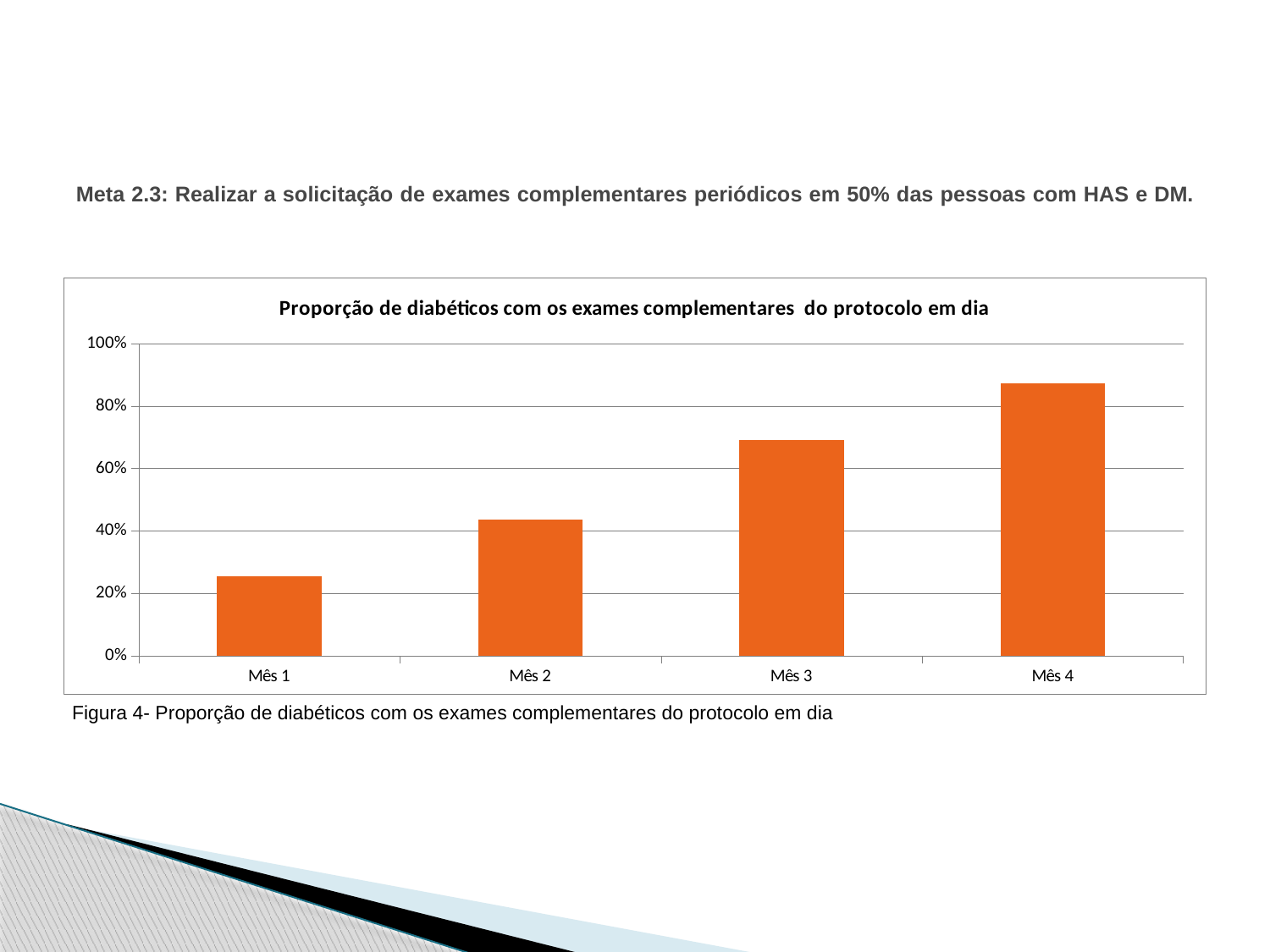
Is the value for Mês 1 greater or less than 40%? less Is the value for Mês 2 greater or less than 40%? greater How many months (categories) are plotted on the x axis? 4 Is the value for Mês 4 greater or less than 80%? greater Which is larger, the value for Mês 2 or the value for Mês 3? Mês 3 Which month has the lowest proportion? Mês 1 What colour are the bars in the chart? orange Which month has the highest proportion? Mês 4 Do the values rise or fall from Mês 1 to Mês 4? rise What kind of chart is shown on the slide? bar chart What is the title of the chart? Proporção de diabéticos com os exames complementares do protocolo em dia